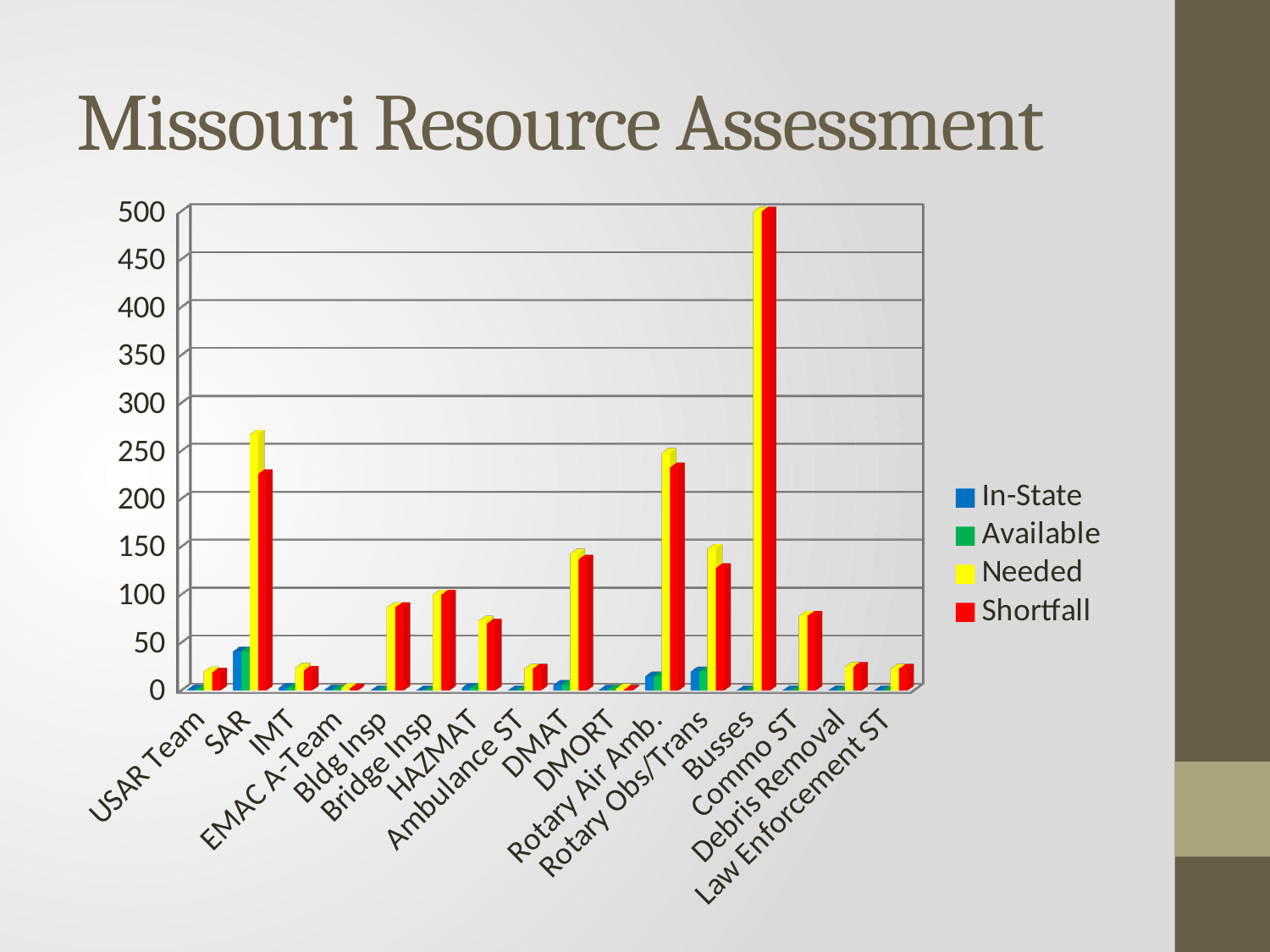
What kind of chart is shown on the slide? bar chart Is the Needed value for Busses greater or less than 400? greater Which category has the highest Needed value? Busses Is the Shortfall value for Rotary Air Amb. greater or less than 200? greater How many series does the legend list? 4 How many categories are shown along the x axis? 16 Which has the larger Needed value, DMAT or HAZMAT? DMAT Is the Needed value for SAR greater or less than 200? greater What colour represents the Shortfall series in the legend? red Which category has the highest In-State value? SAR Which has the larger Needed value, SAR or Rotary Obs/Trans? SAR